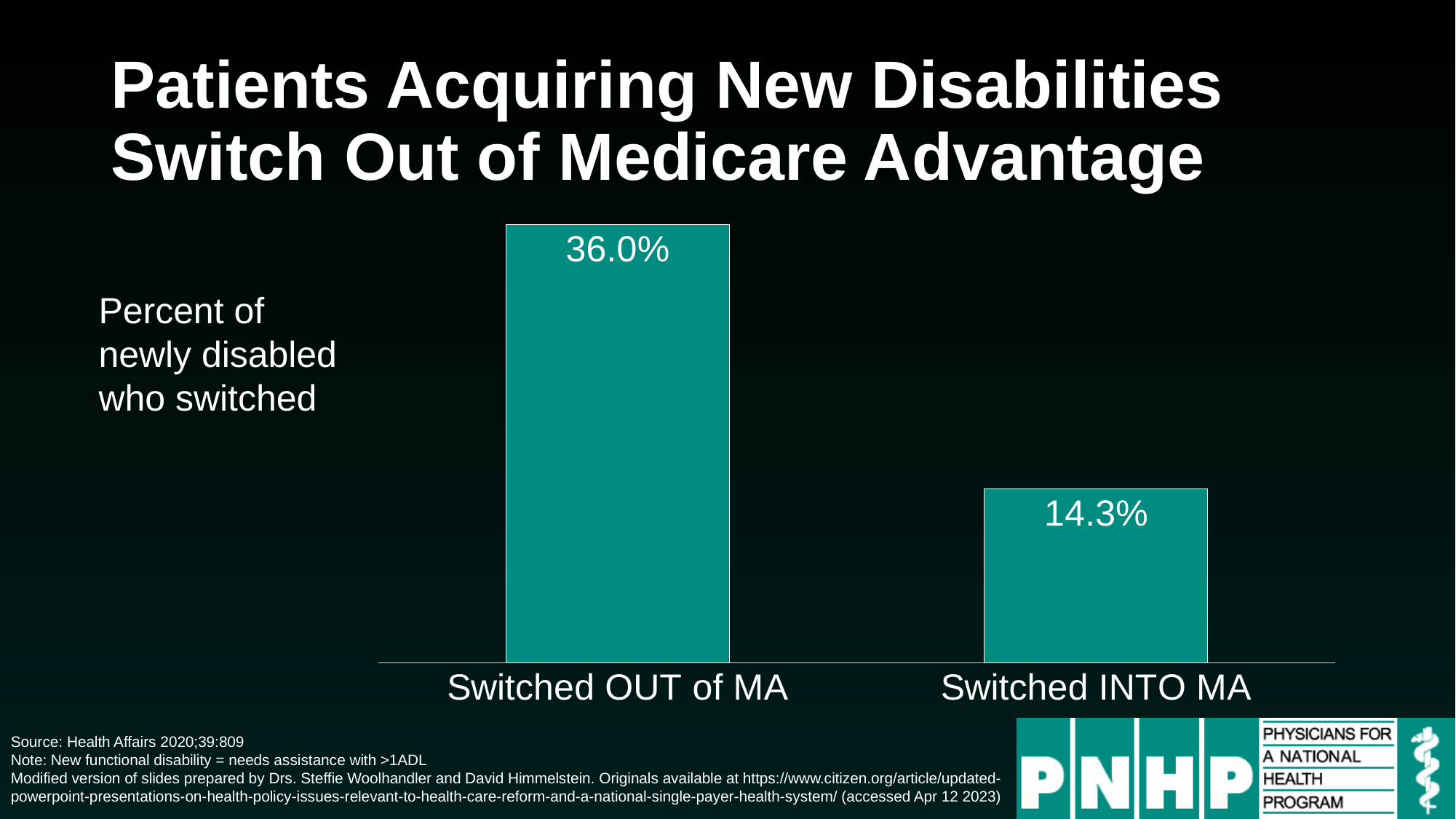
How many categories are shown in the chart? 2 What is the difference between the values for Switched OUT of MA and Switched INTO MA? 21.7% What does the chart measure, according to the label to the left of the bars? Percent of newly disabled who switched What is the title of the slide? Patients Acquiring New Disabilities Switch Out of Medicare Advantage Which category has the highest value? Switched OUT of MA What is the value for Switched OUT of MA? 36.0% Which is larger, the value for Switched OUT of MA or Switched INTO MA? Switched OUT of MA What kind of chart is shown on the slide? Bar chart Which category has the lowest value? Switched INTO MA What is the value for Switched INTO MA? 14.3%